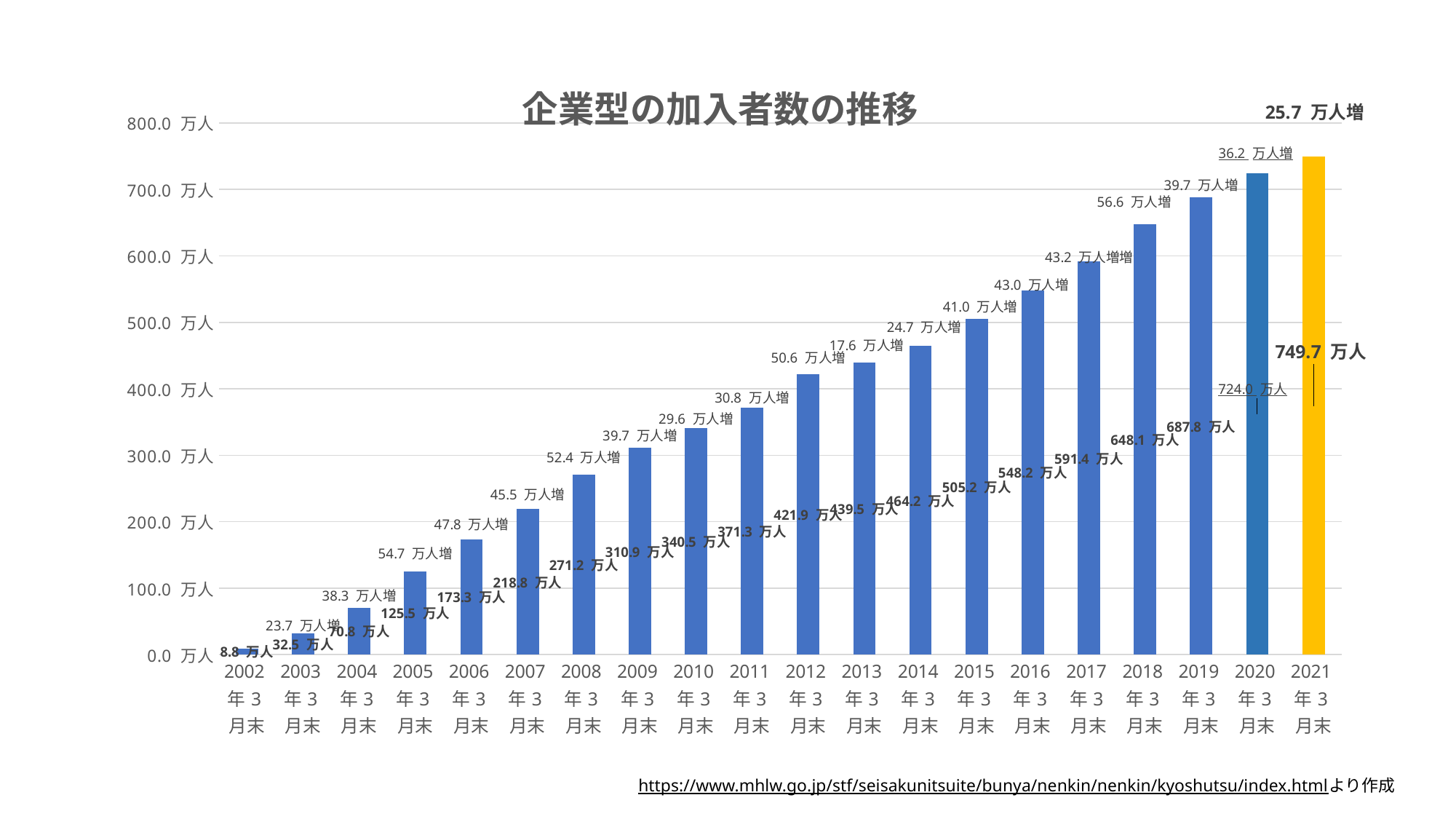
What kind of chart is shown on the slide? bar chart What is the title of the chart? 企業型の加入者数の推移 How many years (bars) are plotted in the chart? 20 Which year has the highest value? 2021年3月末 What is the value for 2012年3月末? 421.9 万人 What is the difference between the values for 2021年3月末 and 2020年3月末? 25.7 万人 Which is larger, the value for 2015年3月末 or 2014年3月末? 2015年3月末 What is the value for 2021年3月末? 749.7 万人 Which year has the lowest value? 2002年3月末 Which bar is shown in a different colour (yellow) from the others? 2021年3月末 Do the values rise or fall from 2002 to 2021 along the x axis? rise What is the value for 2002年3月末? 8.8 万人